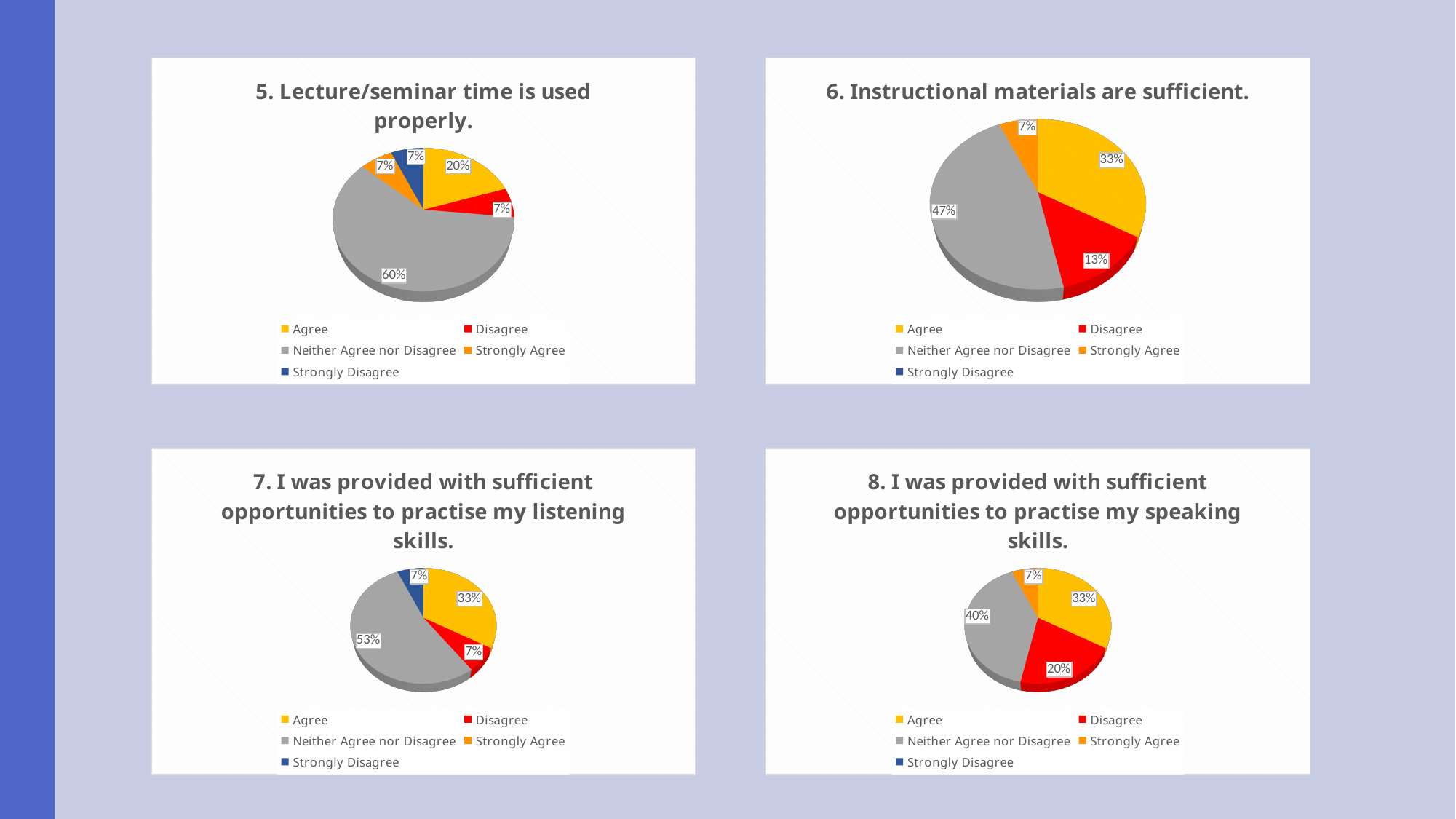
In the chart titled "6. Instructional materials are sufficient.", what is the difference between the Neither Agree nor Disagree and Agree percentages? 14% In the chart titled "6. Instructional materials are sufficient.", which response has the largest slice? Neither Agree nor Disagree In the chart titled "5. Lecture/seminar time is used properly.", what percentage is shown for Neither Agree nor Disagree? 60% In the chart titled "6. Instructional materials are sufficient.", what percentage is shown for Disagree? 13% In the chart titled "8. I was provided with sufficient opportunities to practise my speaking skills.", what percentage is shown for Disagree? 20% What type of chart is used in the top-left chart on the slide? Pie chart In the chart titled "7. I was provided with sufficient opportunities to practise my listening skills.", which is larger, Agree or Disagree? Agree In the chart titled "8. I was provided with sufficient opportunities to practise my speaking skills.", what colour represents Neither Agree nor Disagree? Grey In the chart titled "5. Lecture/seminar time is used properly.", what percentage is shown for Agree? 20% In the chart titled "7. I was provided with sufficient opportunities to practise my listening skills.", what percentage is shown for Neither Agree nor Disagree? 53% How many entries does the legend list in the chart titled "5. Lecture/seminar time is used properly."? 5 In the chart titled "8. I was provided with sufficient opportunities to practise my speaking skills.", what is the difference between the Neither Agree nor Disagree and Agree percentages? 7%